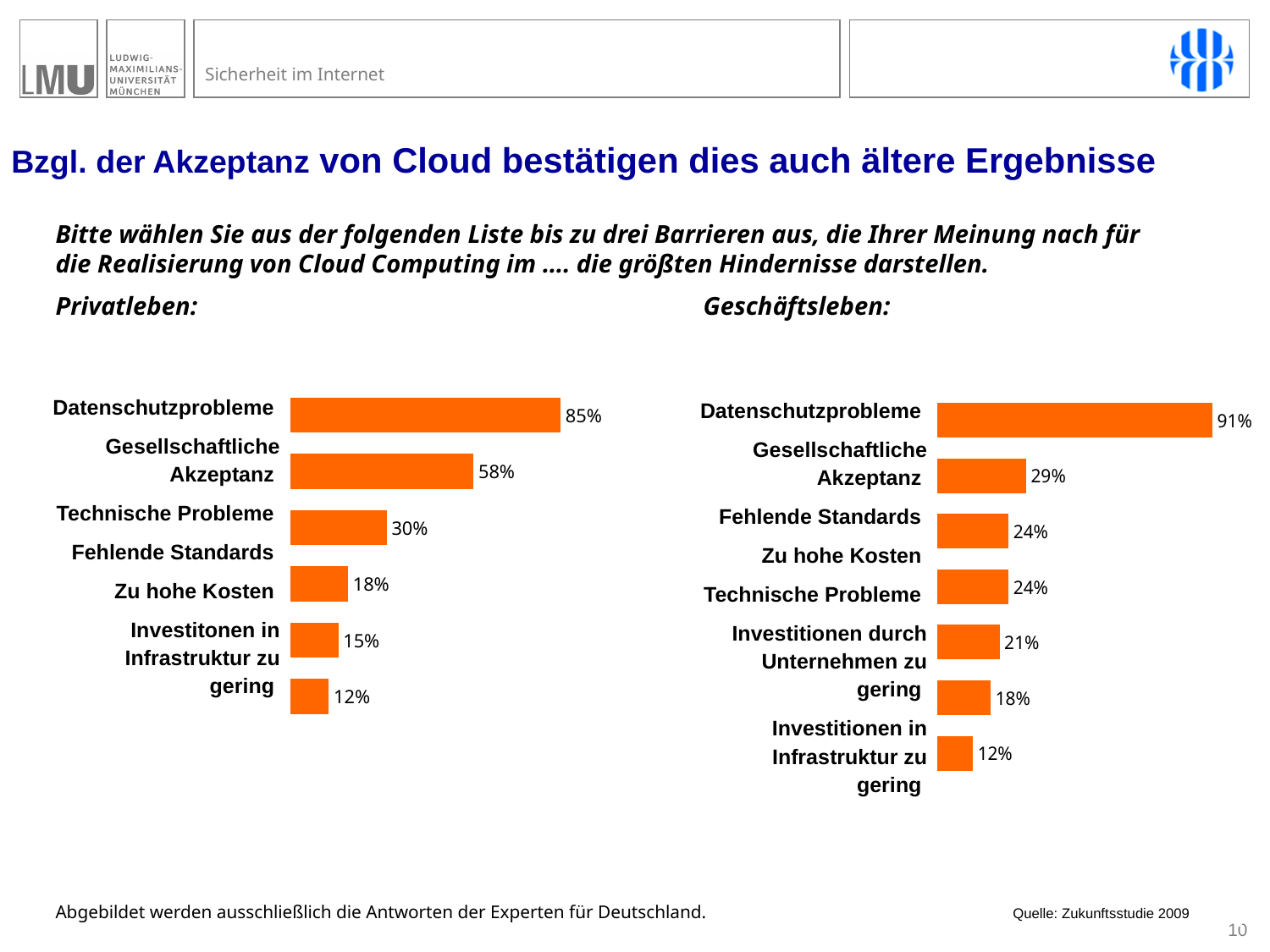
Is the value for Gesellschaftliche Akzeptanz higher in the Privatleben chart or in the Geschäftsleben chart? Privatleben In the Geschäftsleben chart, which category has the highest value? Datenschutzprobleme In the Privatleben chart, what is the value for Datenschutzprobleme? 85% In the Privatleben chart, what is the value for Gesellschaftliche Akzeptanz? 58% In the Geschäftsleben chart, what is the value for Gesellschaftliche Akzeptanz? 29% How many categories are shown in the Geschäftsleben chart? 7 How many categories are shown in the Privatleben chart? 6 In the Privatleben chart, which category has the highest value? Datenschutzprobleme In the Privatleben chart, what is the value for Technische Probleme? 30% In the Geschäftsleben chart, what is the value for Datenschutzprobleme? 91% What type of chart is used for the Privatleben data? Bar chart What is the difference between the Datenschutzprobleme value in the Geschäftsleben chart and in the Privatleben chart? 6 percentage points